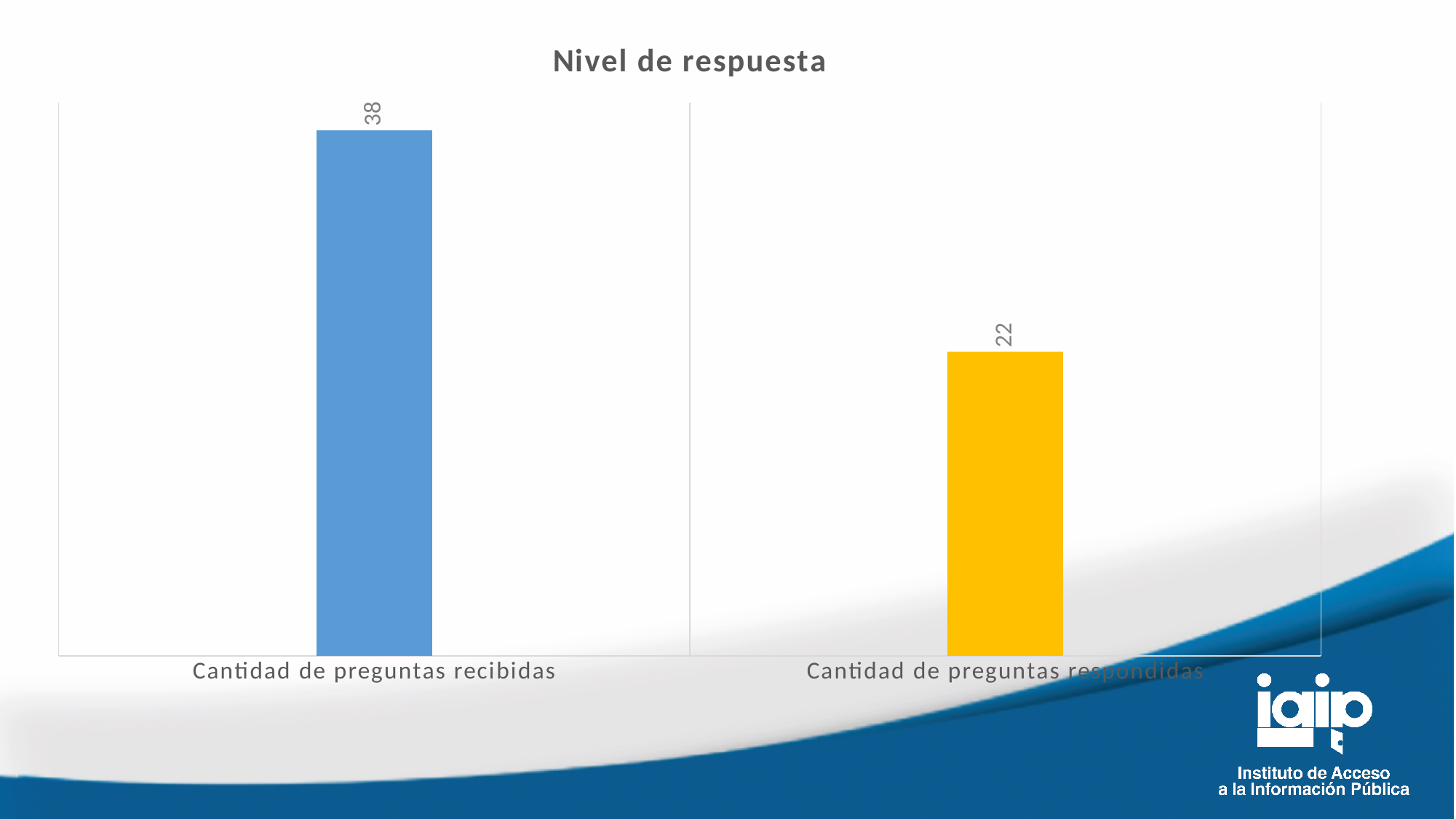
What is the value for Cantidad de preguntas recibidas? 38 Which category has the highest value? Cantidad de preguntas recibidas What is the difference between Cantidad de preguntas recibidas and Cantidad de preguntas respondidas? 16 What colour is the bar for Cantidad de preguntas respondidas? Yellow Which is larger, Cantidad de preguntas recibidas or Cantidad de preguntas respondidas? Cantidad de preguntas recibidas What kind of chart is shown on the slide? Bar chart How many categories are shown in the chart? 2 Which category has the lowest value? Cantidad de preguntas respondidas What is the value for Cantidad de preguntas respondidas? 22 What is the title of the chart? Nivel de respuesta Do the values rise or fall from left to right across the categories? Fall